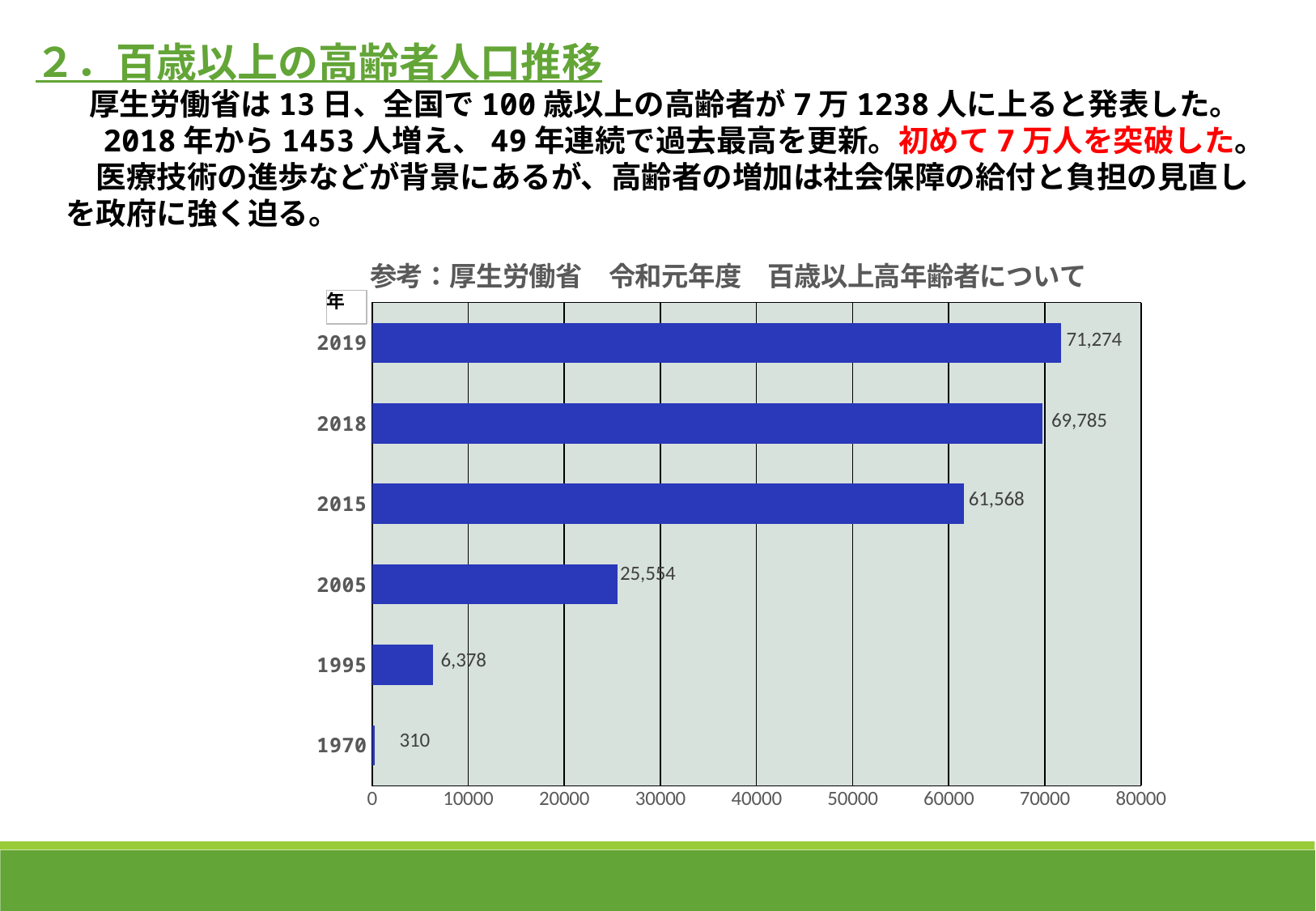
What is the value shown for 2005? 25,554 What is the title of the chart? 参考：厚生労働省 令和元年度 百歳以上高年齢者について What is the value shown for 1970? 310 What is the difference between the values for 2015 and 2005? 36,014 What is the difference between the values for 2019 and 2018? 1,489 What kind of chart is shown on the slide? Bar chart Which is larger, the value for 1995 or the value for 2005? 2005 Is the value for 2018 greater or less than 60000? greater What is the value shown for 2019? 71,274 Which year has the highest value? 2019 How many years are shown on the chart? 6 Which year has the lowest value? 1970